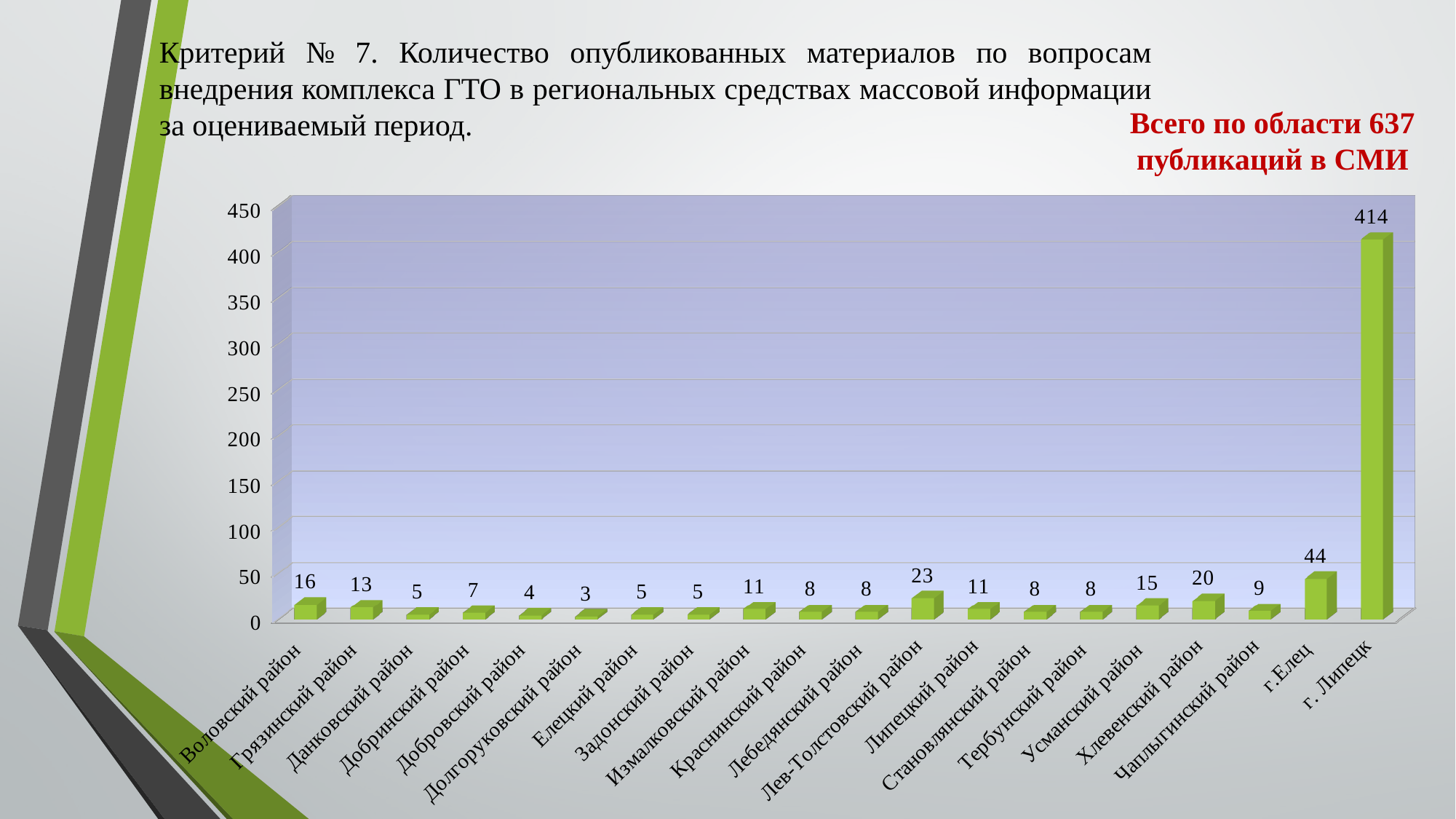
What kind of chart is shown on the slide? bar chart What is the value for г.Елец? 44 Which is larger, the value for Воловский район or Грязинский район? Воловский район What is the value for Хлевенский район? 20 Which category has the highest value? г. Липецк What is the difference between the values for г. Липецк and г.Елец? 370 What is the value for Лев-Толстовский район? 23 According to the red text on the slide, how many publications in the media were there in total for the region? 637 Which category has the lowest value? Долгоруковский район How many categories are shown on the x axis? 20 Is the value for г. Липецк greater or less than 400? greater What is the value for г. Липецк? 414